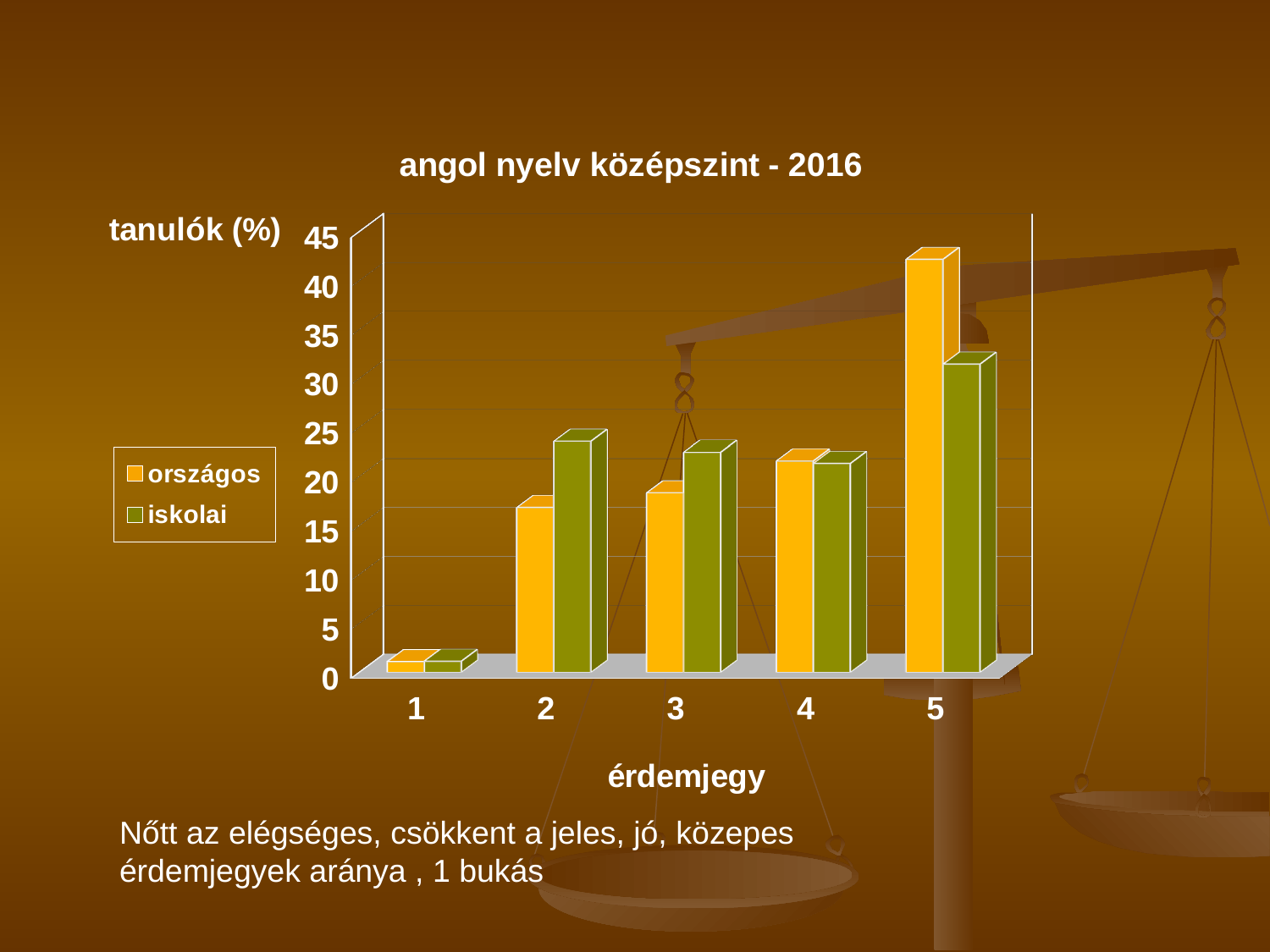
Is the iskolai value for érdemjegy 5 greater or less than 25? greater What are the two series named in the legend? országos and iskolai How many series does the legend list? 2 For which érdemjegy is the iskolai value lowest? 1 How many érdemjegy categories are shown on the x axis? 5 What kind of chart is shown on the slide? bar chart For which érdemjegy is the országos value highest? 5 What is the title of the chart? angol nyelv középszint - 2016 Is the országos value for érdemjegy 1 greater or less than 5? less Is the országos value for érdemjegy 5 greater or less than 35? greater For érdemjegy 2, which is larger: országos or iskolai? iskolai For érdemjegy 5, which is larger: országos or iskolai? országos